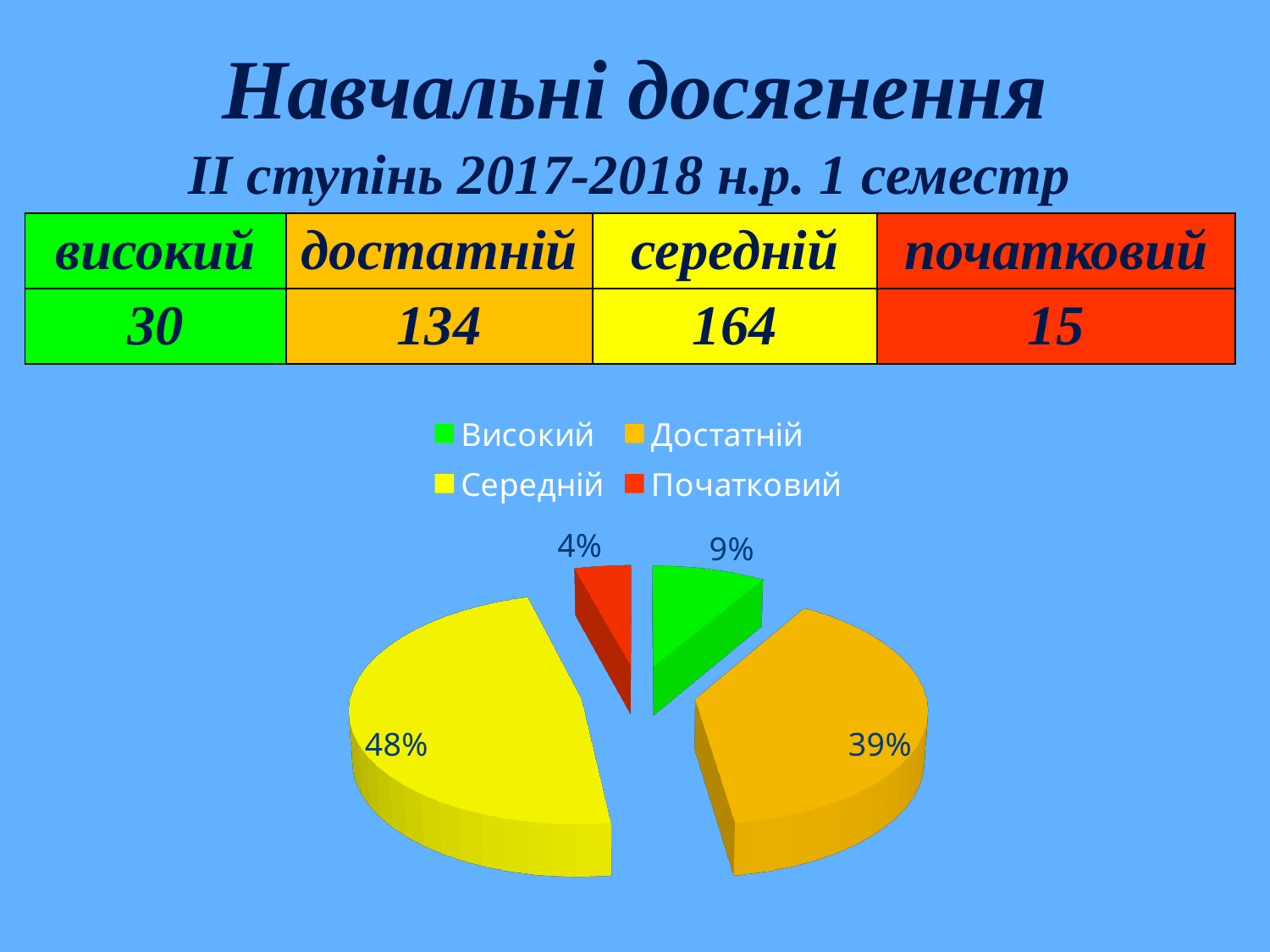
What colour is the Достатній slice in the pie chart? orange Which slice is larger in the pie chart, Високий or Початковий? Високий Which category has the largest slice in the pie chart? Середній How many slices does the pie chart have? 4 What percentage does the pie chart show for Достатній? 39% What type of chart is shown on the slide? pie chart What percentage does the pie chart show for Середній? 48% What percentage does the pie chart show for Високий? 9% What is the difference in percentage points between the Середній and Достатній slices? 9 Which category has the smallest slice in the pie chart? Початковий How many entries does the pie chart legend list? 4 What percentage does the pie chart show for Початковий? 4%